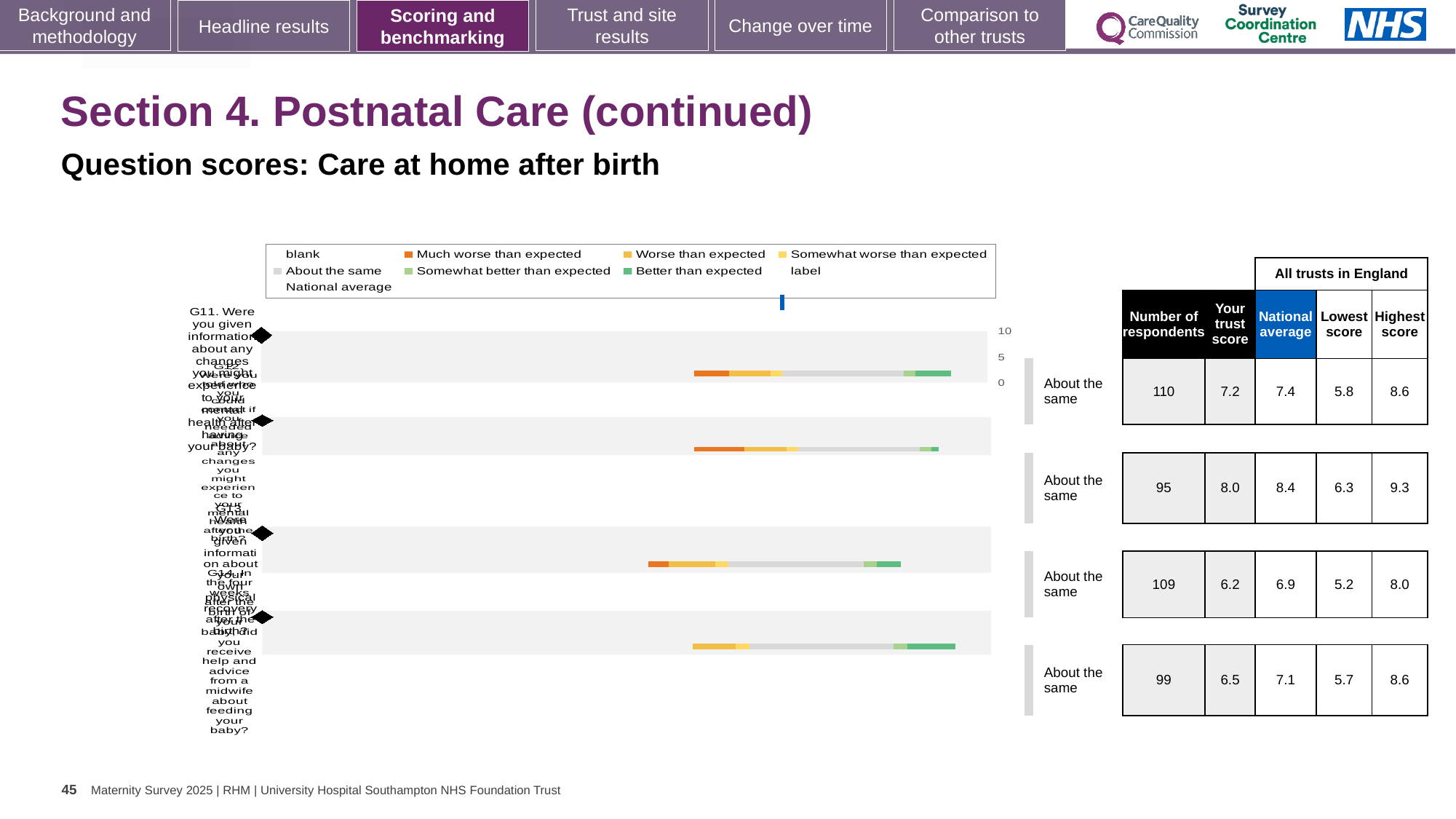
Which row in the table has the lowest 'Your trust score'? the third row (6.2) What is the difference between the national average and the trust score in the first row? 0.2 In the table, what is the 'Your trust score' for the second row? 8.0 In the fourth row, which is larger: the trust score or the national average? the national average (7.1) What is the heading above the 'National average', 'Lowest score' and 'Highest score' columns? All trusts in England What kind of chart is shown on the slide? bar chart In the table, what is the national average for the third row? 6.9 In the table, what is the number of respondents for the first (top) row? 110 What benchmark category is shown for all four rows? About the same How many question rows are plotted in the chart? 4 Which row in the table has the highest 'Your trust score'? the second row (8.0) In the table, what is the highest score for the fourth (bottom) row? 8.6